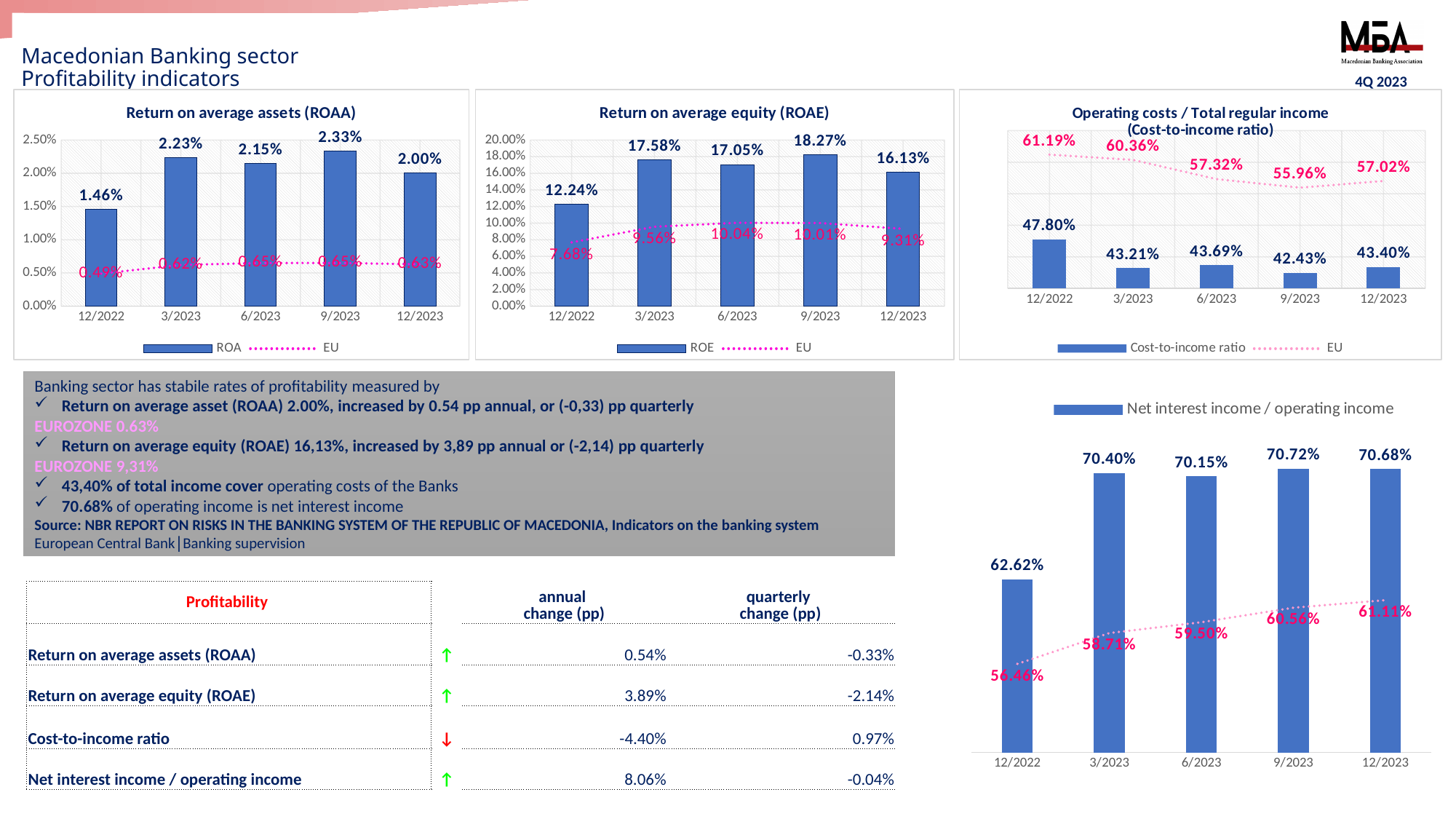
In the 'Operating costs / Total regular income (Cost-to-income ratio)' chart, what is the EU value for 6/2023? 57.32% In the 'Return on average assets (ROAA)' chart, what is the EU value for 12/2022? 0.49% In the 'Operating costs / Total regular income (Cost-to-income ratio)' chart, which is larger for 12/2022: the Cost-to-income ratio or the EU value? EU In the 'Net interest income / operating income' chart, what is the bar value for 12/2022? 62.62% In the 'Net interest income / operating income' chart, does the dotted line rise or fall from 12/2022 to 12/2023? rise In the 'Return on average equity (ROAE)' chart, what is the ROE value for 3/2023? 17.58% In the 'Return on average equity (ROAE)' chart, which period has the lowest ROE value? 12/2022 In the 'Return on average equity (ROAE)' chart, what is the difference between the ROE value and the EU value for 12/2023? 6.82% In the 'Operating costs / Total regular income (Cost-to-income ratio)' chart, what is the Cost-to-income ratio for 9/2023? 42.43% In the 'Return on average assets (ROAA)' chart, what is the ROA value for 12/2023? 2.00% In the 'Return on average assets (ROAA)' chart, which period has the highest ROA value? 9/2023 How many periods are shown on the x axis of the 'Return on average assets (ROAA)' chart? 5